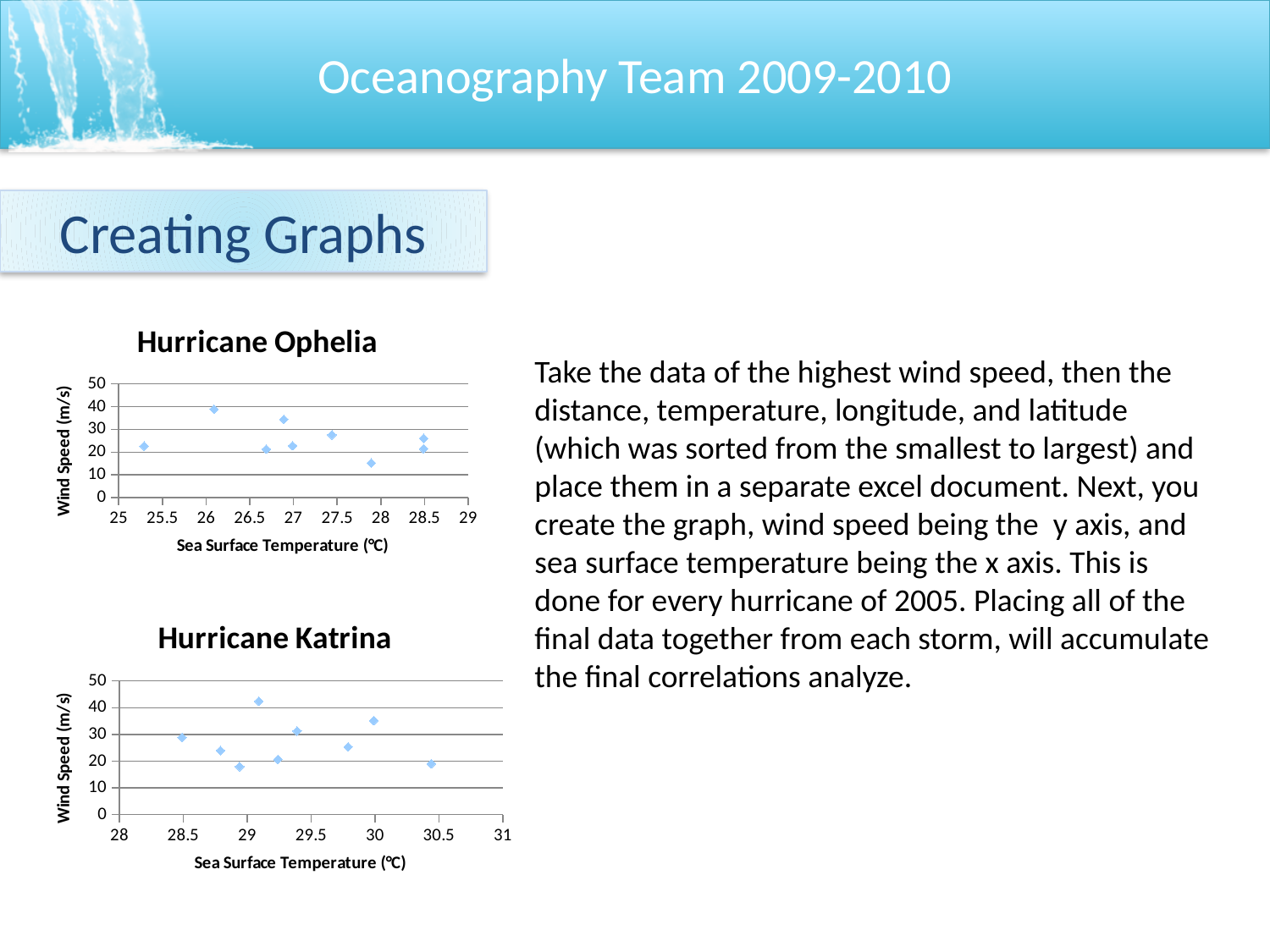
How many data points are plotted in the Hurricane Katrina chart? 9 In the Hurricane Katrina chart, is the highest wind speed plotted greater or less than 30? greater In the Hurricane Katrina chart, what is the maximum value shown on the x axis? 31 In the Hurricane Katrina chart, is the lowest wind speed plotted greater or less than 30? less In the Hurricane Katrina chart, what is the label of the x axis? Sea Surface Temperature (°C) How many data points are plotted in the Hurricane Ophelia chart? 9 In the Hurricane Ophelia chart, is the lowest wind speed plotted greater or less than 20? less What kind of chart is the Hurricane Katrina chart? scatter chart What kind of chart is the Hurricane Ophelia chart? scatter chart In the Hurricane Ophelia chart, is the wind speed of the point at about 26 °C greater or less than the wind speed of the point at about 28 °C? greater In the Hurricane Ophelia chart, what is the label of the y axis? Wind Speed (m/s)